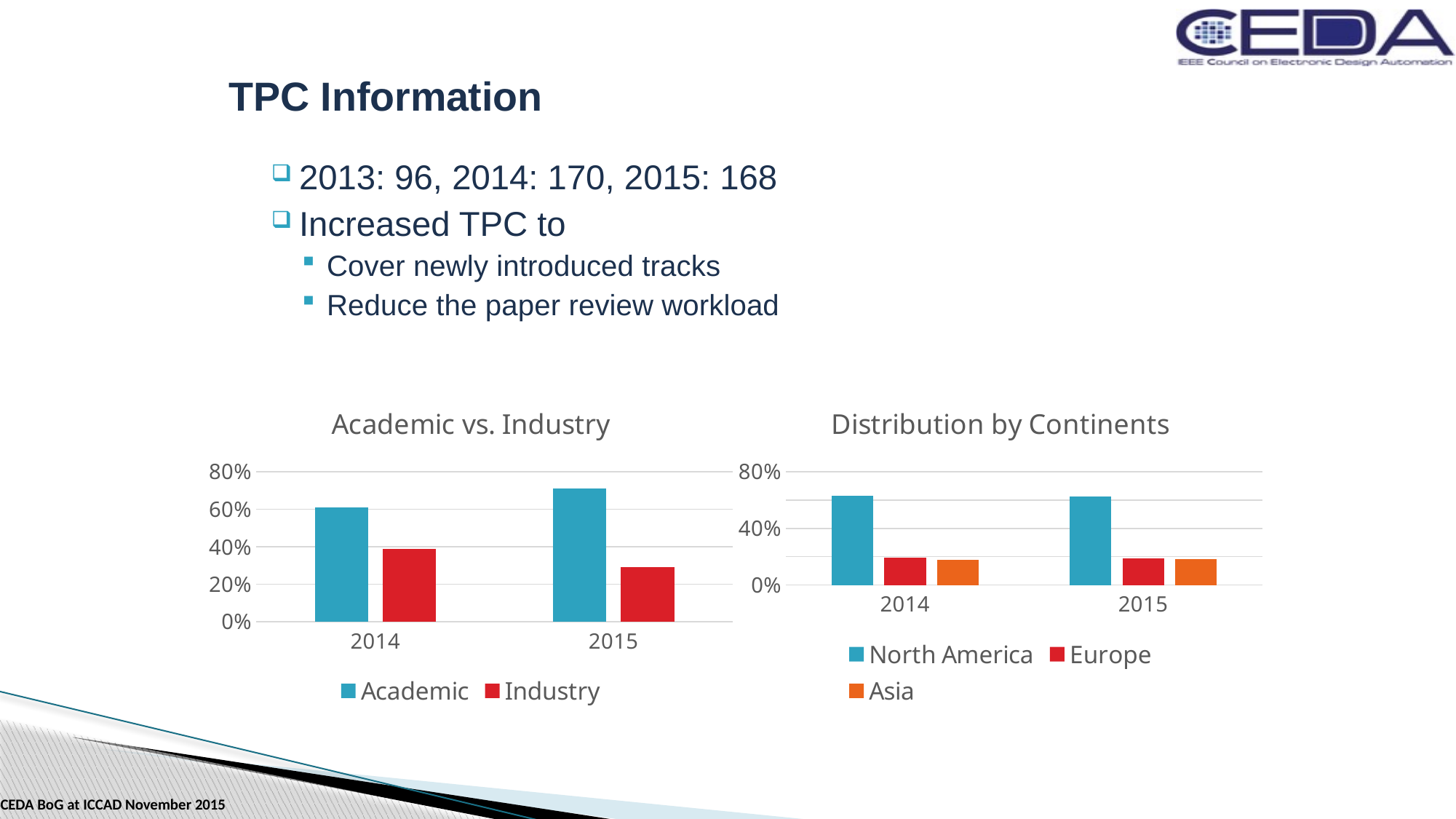
In the "Distribution by Continents" chart, which continent has the highest value in 2015? North America What kind of chart is the "Academic vs. Industry" chart? bar chart In the "Academic vs. Industry" chart, does the Academic value rise or fall from 2014 to 2015? rise In the "Academic vs. Industry" chart, is the Academic value for 2014 greater or less than 40%? greater In the "Academic vs. Industry" chart, is the Academic value for 2015 greater or less than 60%? greater How many series does the legend of the "Distribution by Continents" chart list? 3 In the "Distribution by Continents" chart, is the North America value for 2014 greater or less than 40%? greater In the "Academic vs. Industry" chart, how many years are shown on the x axis? 2 In the "Distribution by Continents" chart, which series is shown in orange? Asia In the "Academic vs. Industry" chart, which is larger in 2014, Academic or Industry? Academic How many series does the legend of the "Academic vs. Industry" chart list? 2